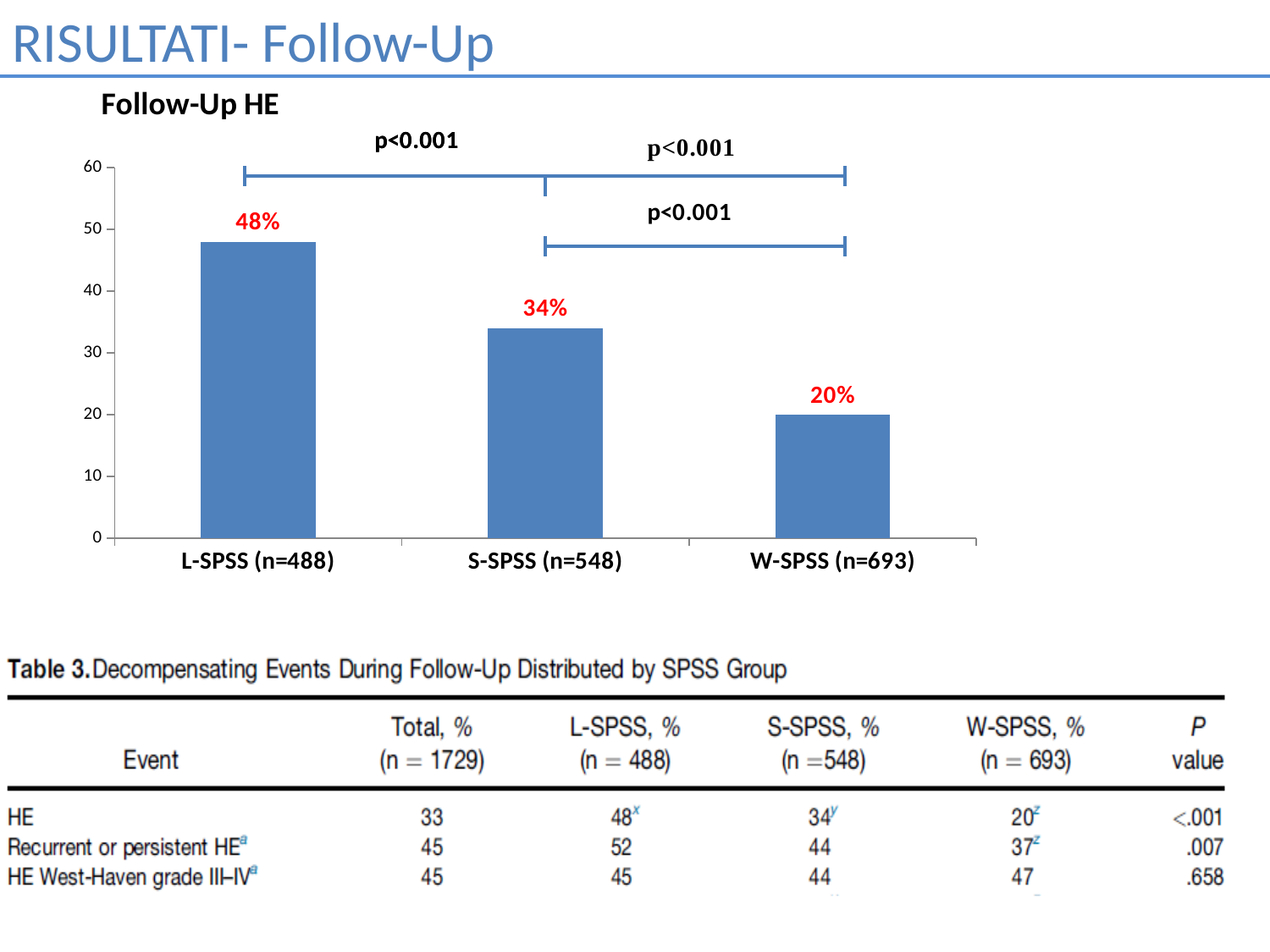
Which is larger in the Follow-Up HE chart, the value for S-SPSS (n=548) or W-SPSS (n=693)? S-SPSS (n=548) How many categories are shown in the Follow-Up HE chart? 3 What is the value for S-SPSS (n=548) in the Follow-Up HE chart? 34% Do the values in the Follow-Up HE chart rise or fall from left to right along the x axis? fall What is the difference between the values for L-SPSS (n=488) and S-SPSS (n=548) in the Follow-Up HE chart? 14% What is the value for L-SPSS (n=488) in the Follow-Up HE chart? 48% What is the value for W-SPSS (n=693) in the Follow-Up HE chart? 20% What kind of chart is the Follow-Up HE chart? bar chart Is the value for S-SPSS (n=548) in the Follow-Up HE chart greater or less than 30? greater Which category has the highest value in the Follow-Up HE chart? L-SPSS (n=488) What is the difference between the values for L-SPSS (n=488) and W-SPSS (n=693) in the Follow-Up HE chart? 28% Which category has the lowest value in the Follow-Up HE chart? W-SPSS (n=693)